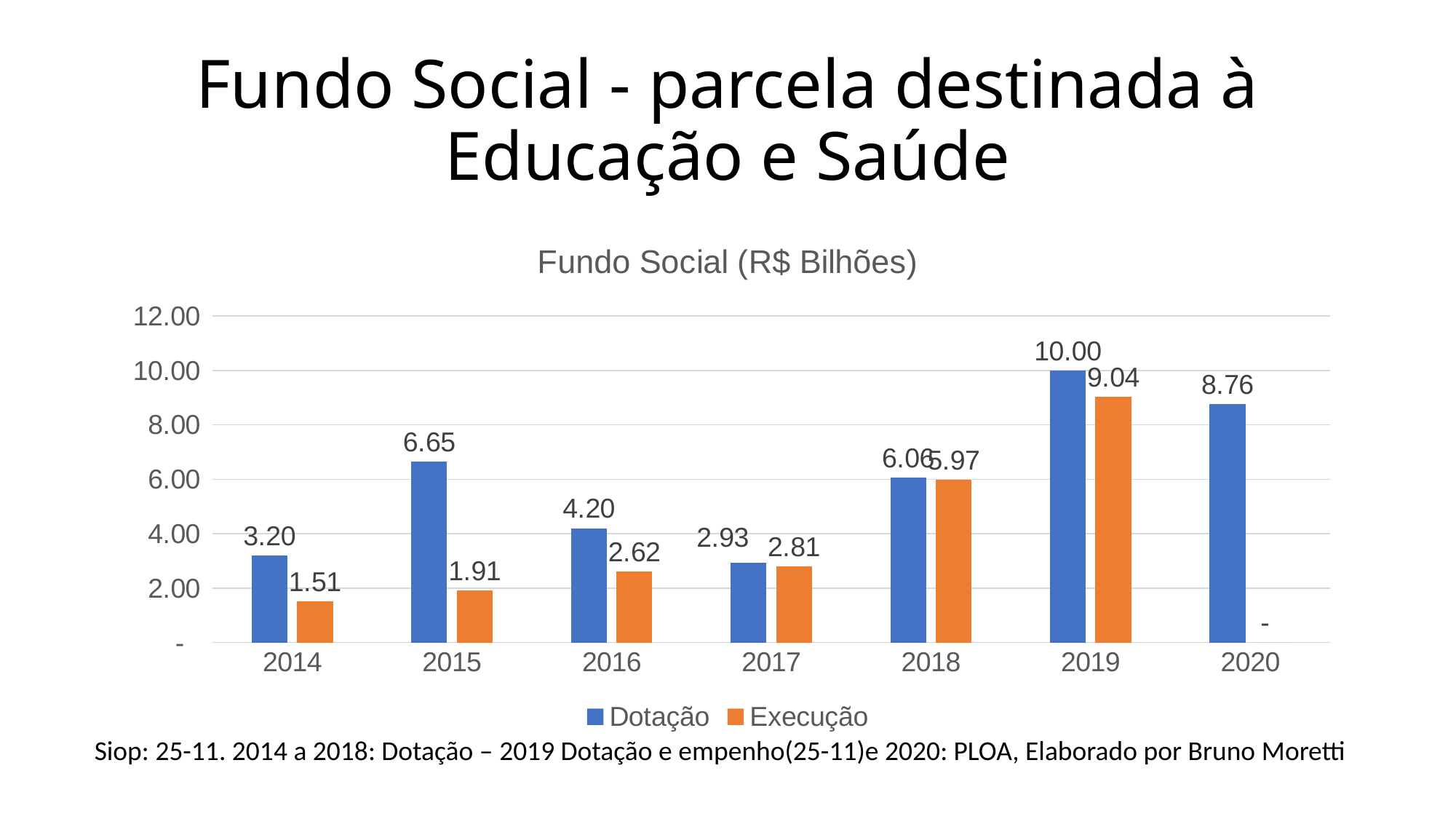
What is the difference between Dotação and Execução in 2014? 1.69 How many series does the legend list? 2 What is the Dotação value for 2015? 6.65 What kind of chart is shown on the slide? Bar chart In which year is the Execução value lowest among the years with a plotted Execução bar? 2014 What is the difference between Dotação and Execução in 2019? 0.96 How many years are shown on the x axis? 7 What is the Execução value for 2019? 9.04 What is the Execução value for 2016? 2.62 Is the Dotação value for 2020 greater or less than 8.00? greater Which year has the larger Dotação value, 2016 or 2017? 2016 In which year is the Dotação value highest? 2019